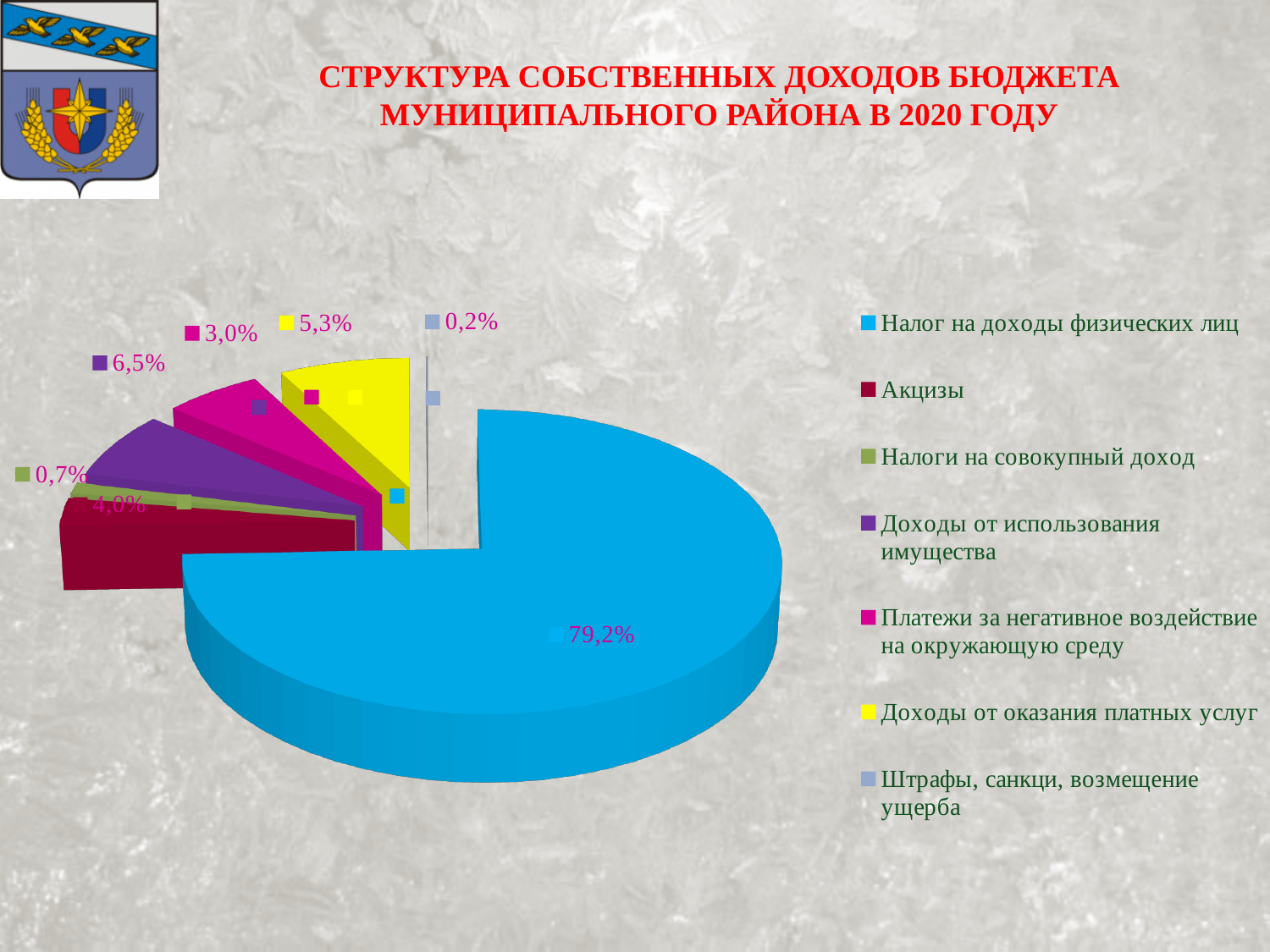
What is the value shown for "Доходы от использования имущества"? 6,5% What is the title of the chart? СТРУКТУРА СОБСТВЕННЫХ ДОХОДОВ БЮДЖЕТА МУНИЦИПАЛЬНОГО РАЙОНА В 2020 ГОДУ What is the value shown for "Доходы от оказания платных услуг"? 5,3% What is the value shown for "Штрафы, санкци, возмещение ущерба"? 0,2% What is the value shown for "Акцизы"? 4,0% How many categories does the legend list? 7 Which category has the smallest share of the pie? Штрафы, санкци, возмещение ущерба What share of the pie does "Налог на доходы физических лиц" have? 79,2% Which is larger: the share for "Доходы от использования имущества" or the share for "Доходы от оказания платных услуг"? Доходы от использования имущества What is the difference between the shares for "Акцизы" and "Платежи за негативное воздействие на окружающую среду"? 1,0% What type of chart is shown on the slide? pie chart Which category has the largest share of the pie? Налог на доходы физических лиц